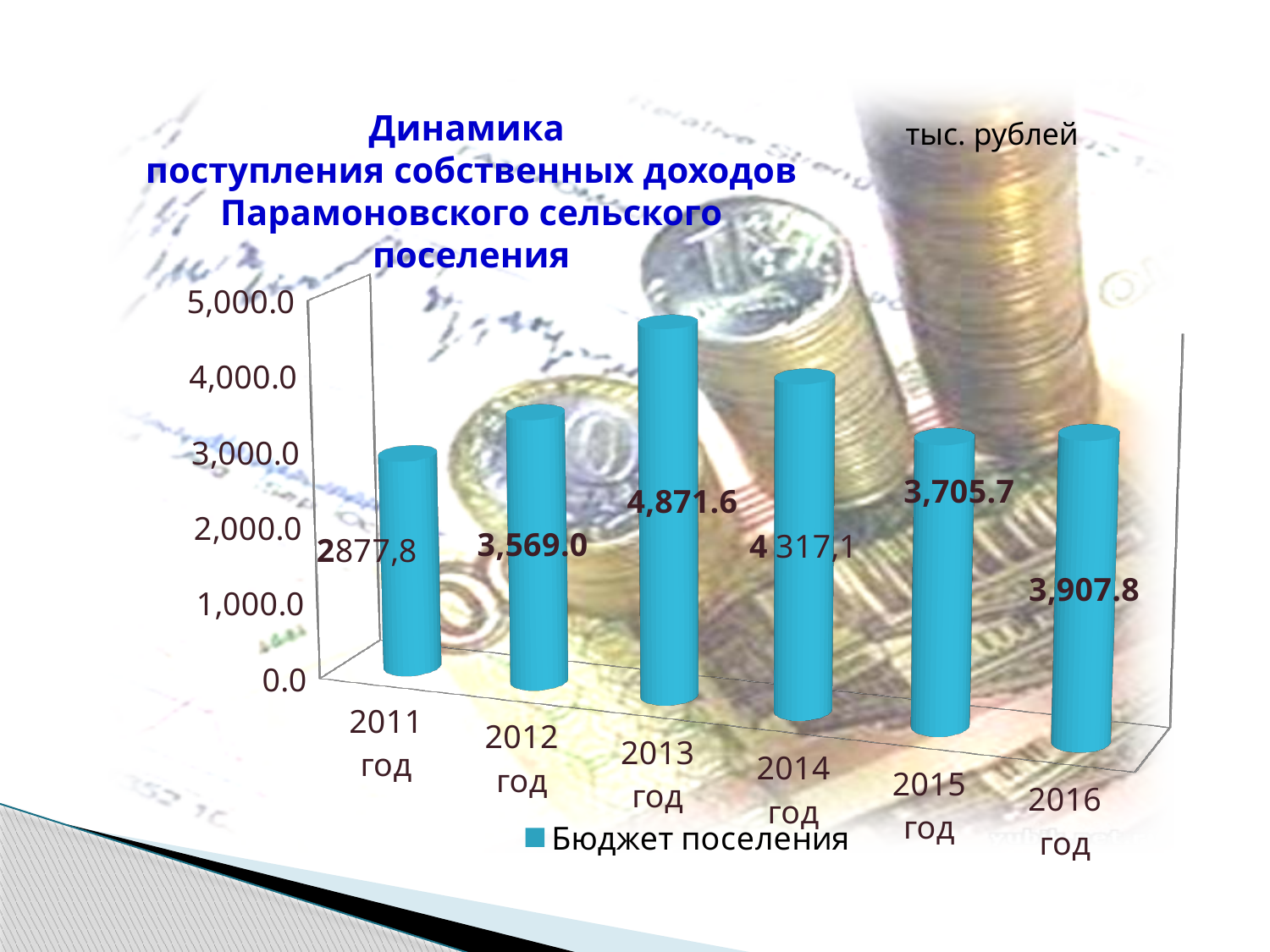
What is the value for 2013 год? 4,871.6 Is the value for 2013 год greater or less than 4,000.0? greater Which is larger, the value for 2014 год or 2015 год? 2014 год What is the difference between the values for 2013 год and 2012 год? 1,302.6 How many years are shown on the x axis? 6 What is the legend entry for the series? Бюджет поселения Which year has the highest value? 2013 год Which year has the lowest value? 2011 год What is the value for 2015 год? 3,705.7 What is the value for 2016 год? 3,907.8 What is the value for 2012 год? 3,569.0 What kind of chart is shown on the slide? bar chart